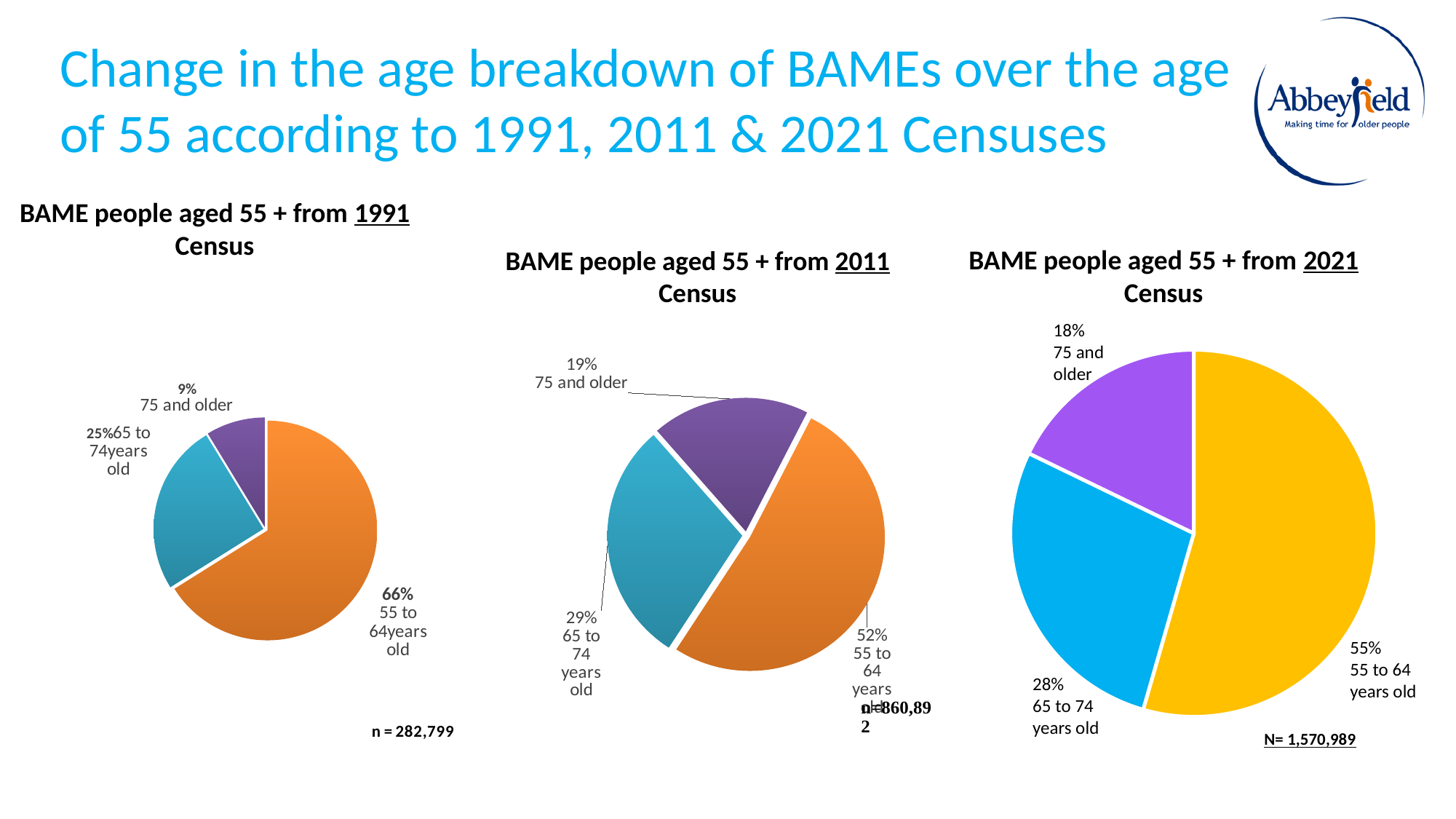
In the 2011 Census pie chart, what percentage is shown for the 65 to 74 years old group? 29% In the 2021 Census pie chart, what share of the pie is the 75 and older group? 18% What is the sample size (n) shown under the 1991 Census pie chart? n = 282,799 In the 2021 Census pie chart, which age group has the largest slice? 55 to 64 years old Is the 75 and older share larger in the 2011 Census chart or the 2021 Census chart? 2011 Census chart What is the difference between the 55 to 64 years old share in the 1991 Census chart and in the 2011 Census chart? 14 percentage points In the 2011 Census pie chart, which age group has the smallest slice? 75 and older What is the N value shown under the 2021 Census pie chart? N= 1,570,989 In the 1991 Census pie chart, what percentage is shown for the 75 and older group? 9% What type of chart is used for the 1991 Census data? Pie chart In the 1991 Census pie chart, what share of BAME people aged 55+ are 55 to 64 years old? 66% How many slices does the 2021 Census pie chart have? 3